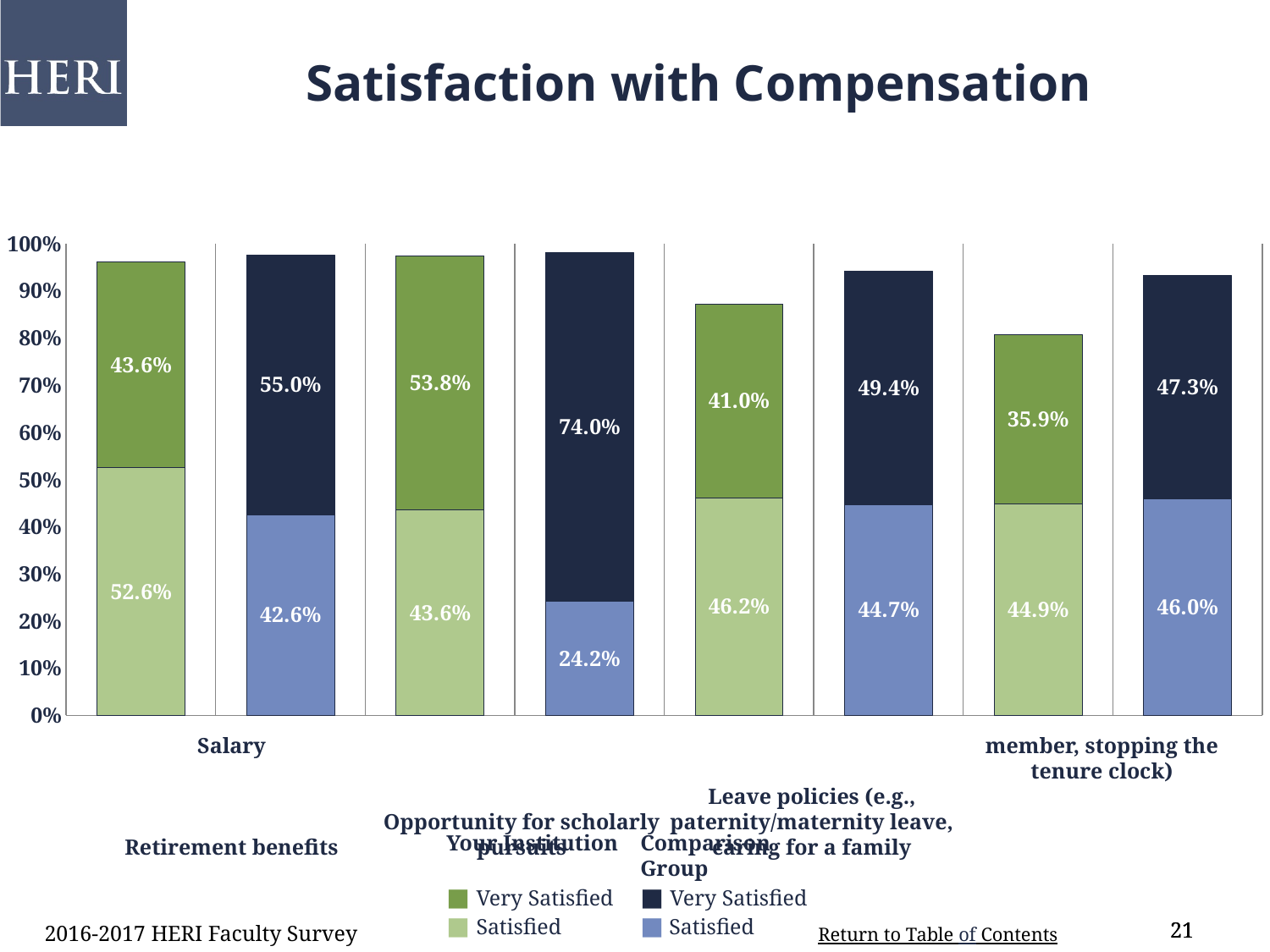
What is the difference between the Comparison Group's Very Satisfied percentage for Retirement benefits and Your Institution's Very Satisfied percentage for Retirement benefits? 20.2% Which category has the highest Very Satisfied percentage for the Comparison Group? Retirement benefits Which is larger: the Satisfied percentage for Your Institution on Salary or the Satisfied percentage for the Comparison Group on Salary? Your Institution What percentage of Your Institution faculty are Satisfied with Opportunity for scholarly pursuits? 46.2% What type of chart is shown on the slide? Stacked bar chart What percentage of Your Institution faculty are Very Satisfied with Salary? 43.6% What is the combined Satisfied and Very Satisfied percentage for the Comparison Group on Opportunity for scholarly pursuits? 94.1% How many compensation categories are shown on the x axis? 4 What percentage of the Comparison Group is Very Satisfied with Leave policies? 47.3% What is the combined Satisfied and Very Satisfied percentage for Your Institution on Salary? 96.2% Which category has the lowest Very Satisfied percentage for Your Institution? Leave policies What percentage of the Comparison Group is Satisfied with Retirement benefits? 24.2%